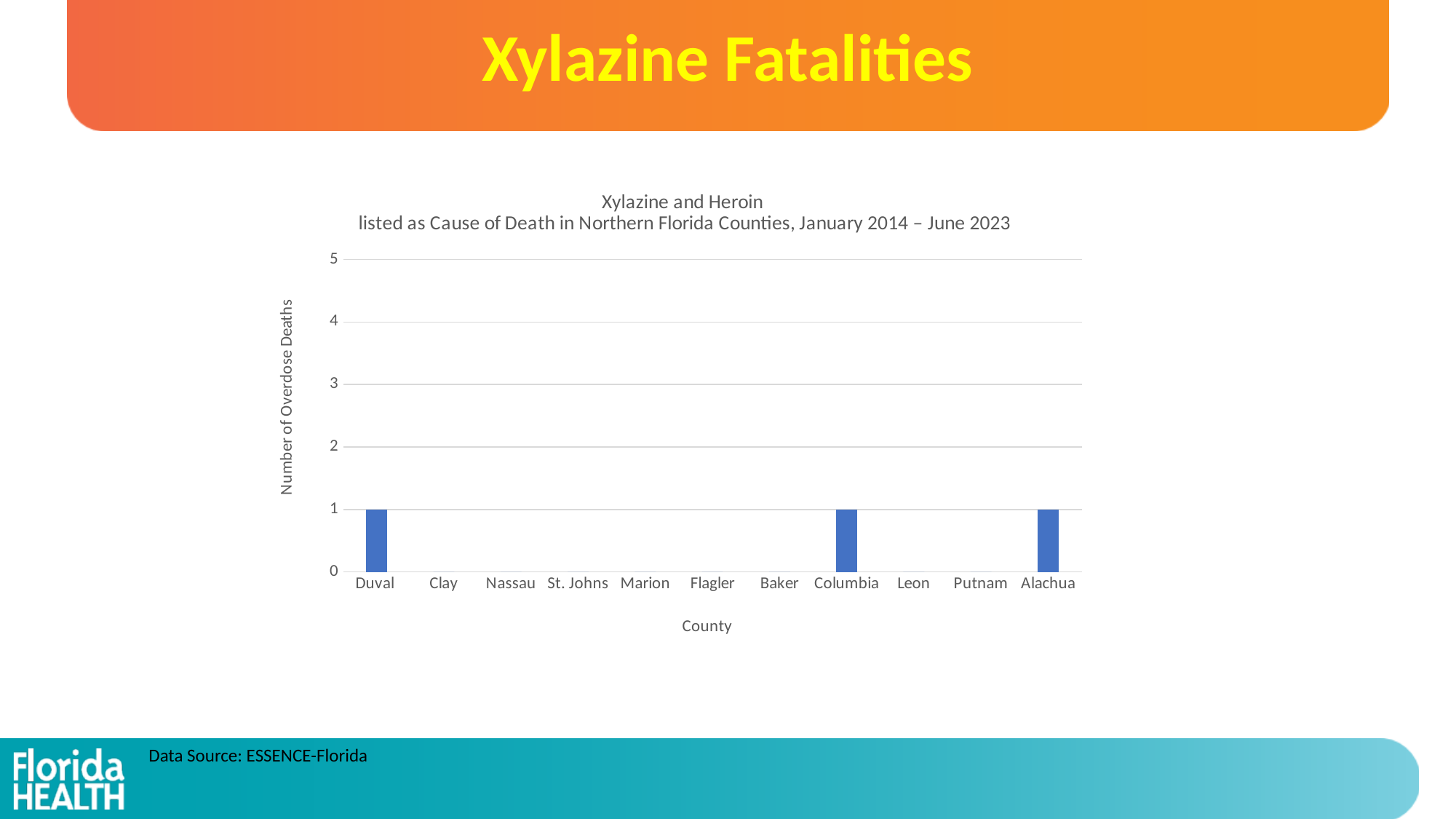
What is the number of overdose deaths for Duval? 1 What is the number of overdose deaths for Clay? 0 What is the label of the y axis of the chart? Number of Overdose Deaths How many counties are shown on the x axis of the chart? 11 What time period does the chart title say the data covers? January 2014 – June 2023 What is the number of overdose deaths for Alachua? 1 Which counties have a bar showing a value of 1? Duval, Columbia, Alachua Is the value for Duval greater or less than 2? less What is the number of overdose deaths for Columbia? 1 What is the difference between the values for Alachua and Putnam? 1 What kind of chart is shown on the slide? Bar chart Which is larger, the value for Columbia or the value for Leon? Columbia